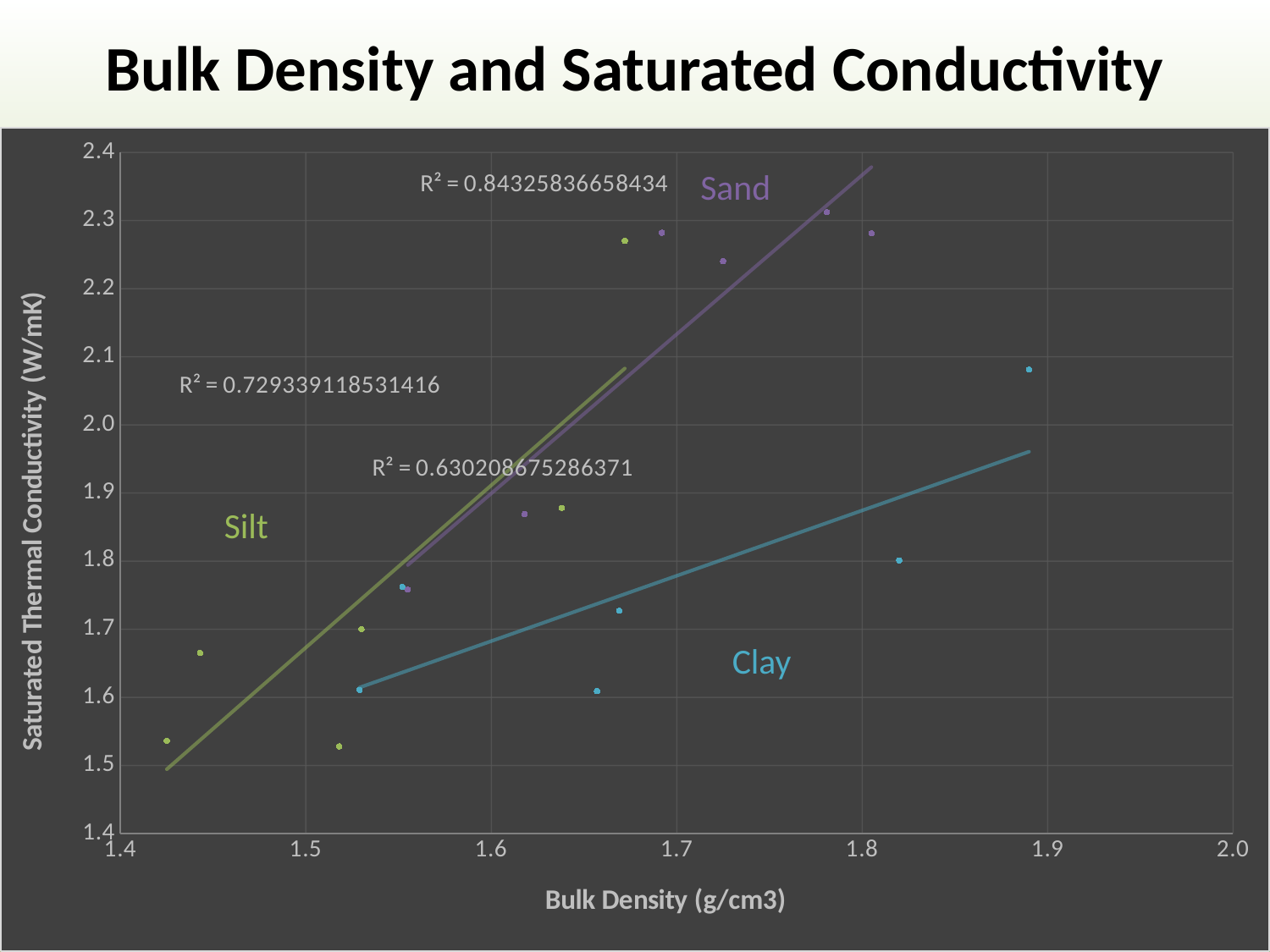
What kind of chart is shown on the slide? scatter chart What R² value is printed next to the Sand label? R² = 0.84325836658434 Is the saturated thermal conductivity of the Clay point at the highest bulk density greater or less than 2.0? greater Which soil type has the point with the highest bulk density? Clay Which soil type has the shallowest trendline? Clay What is the lowest R² value printed on the chart? 0.630208675286371 What is the label of the x axis? Bulk Density (g/cm3) What is the title of the chart? Bulk Density and Saturated Conductivity What is the highest R² value printed on the chart? 0.84325836658434 How many soil types are labelled on the chart? 3 Does the Clay trendline rise or fall as bulk density increases? rises Is the saturated thermal conductivity of the Silt point at the lowest bulk density greater or less than 1.6? less